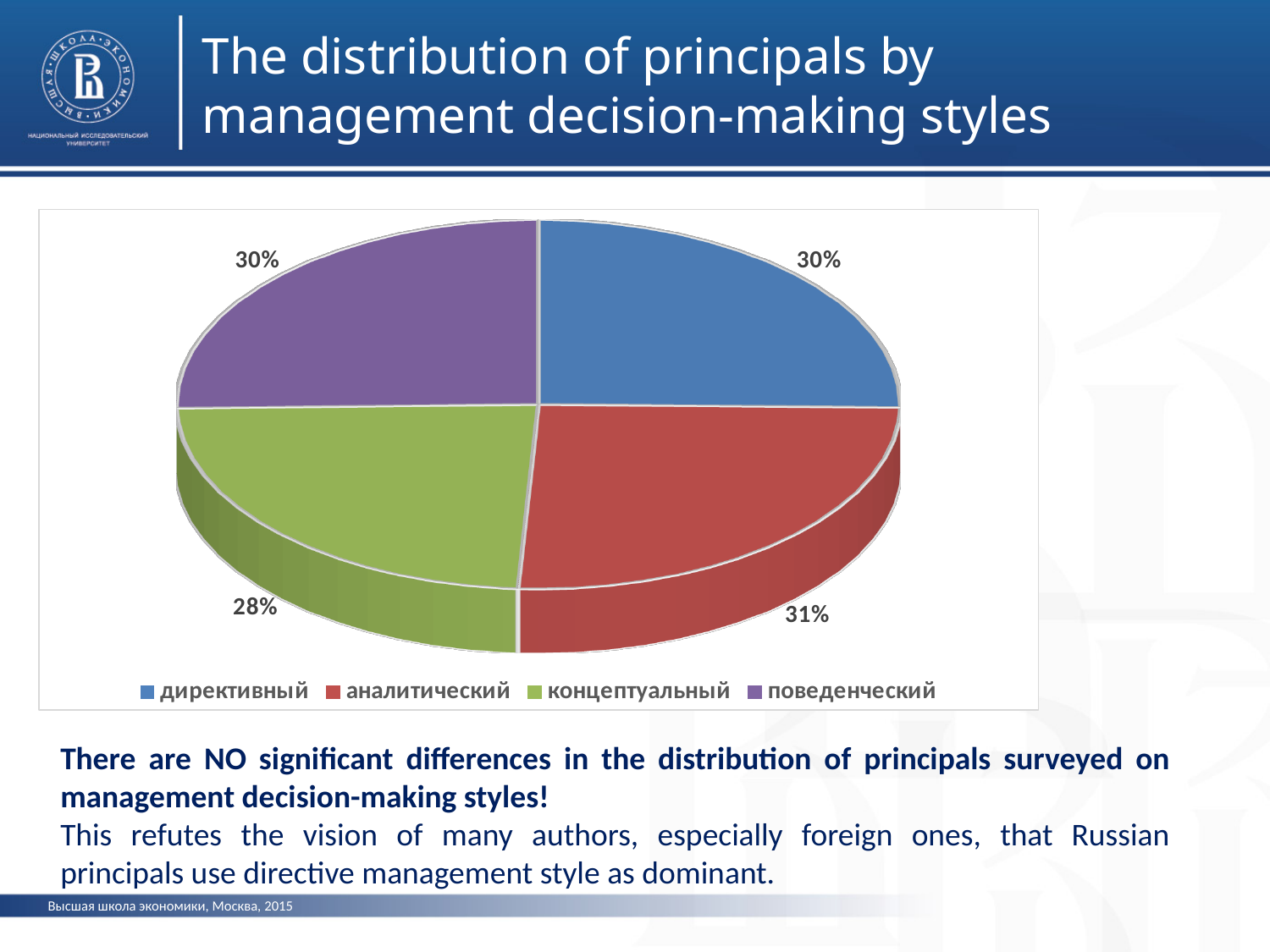
Which decision-making style has the smallest share of principals? концептуальный What type of chart is shown on the slide? Pie chart What percentage of principals have the директивный decision-making style? 30% How many decision-making styles are shown in the pie chart? 4 How many entries does the chart legend list? 4 What is the difference in percentage points between the аналитический and концептуальный shares? 3 percentage points Which decision-making style has the largest share of principals? аналитический What percentage of principals have the поведенческий decision-making style? 30% What percentage of principals have the концептуальный decision-making style? 28% What colour is the slice for поведенческий? Purple Which has a larger share, аналитический or директивный? аналитический What percentage of principals have the аналитический decision-making style? 31%